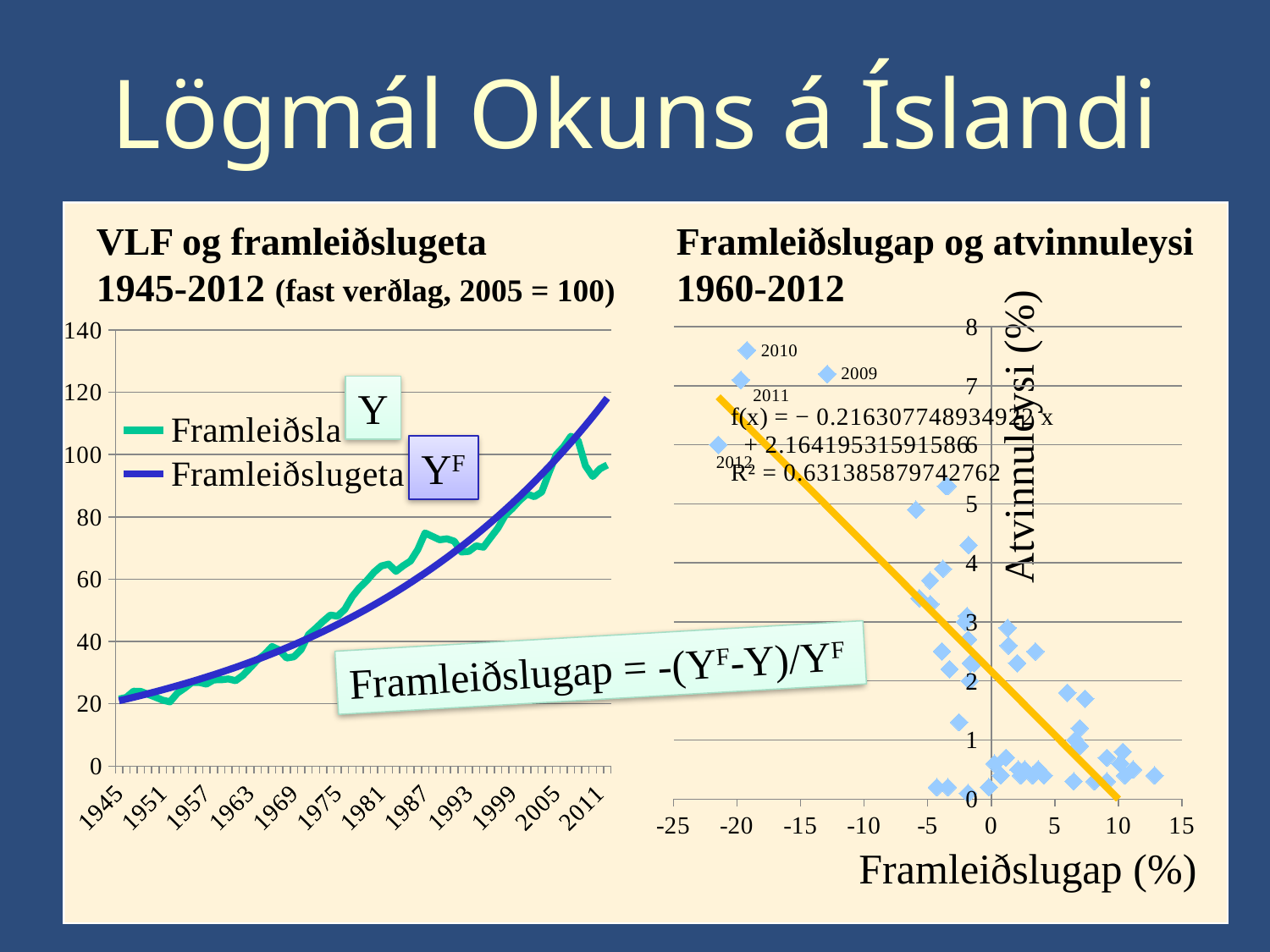
On the right chart 'Framleiðslugap og atvinnuleysi 1960-2012', is the Atvinnuleysi value for the point labelled 2010 greater or less than 7? greater On the right chart 'Framleiðslugap og atvinnuleysi 1960-2012', is the Framleiðslugap value for the point labelled 2010 greater or less than -15? less What kind of chart is the left chart, 'VLF og framleiðslugeta 1945-2012'? line chart On the left chart 'VLF og framleiðslugeta 1945-2012', is the value of Framleiðsla in 1981 greater or less than 80? less How many series does the legend of the left chart 'VLF og framleiðslugeta 1945-2012' list? 2 On the left chart 'VLF og framleiðslugeta 1945-2012', does the Framleiðslugeta series rise or fall from 1945 to 2011? rise What kind of chart is the right chart, 'Framleiðslugap og atvinnuleysi 1960-2012'? scatter chart What are the two legend entries on the left chart 'VLF og framleiðslugeta 1945-2012'? Framleiðsla and Framleiðslugeta On the right chart 'Framleiðslugap og atvinnuleysi 1960-2012', which of the labelled years, 2009 or 2010, has the higher Atvinnuleysi value? 2010 On the right chart 'Framleiðslugap og atvinnuleysi 1960-2012', what R² value is shown for the trendline? 0.631385879742762